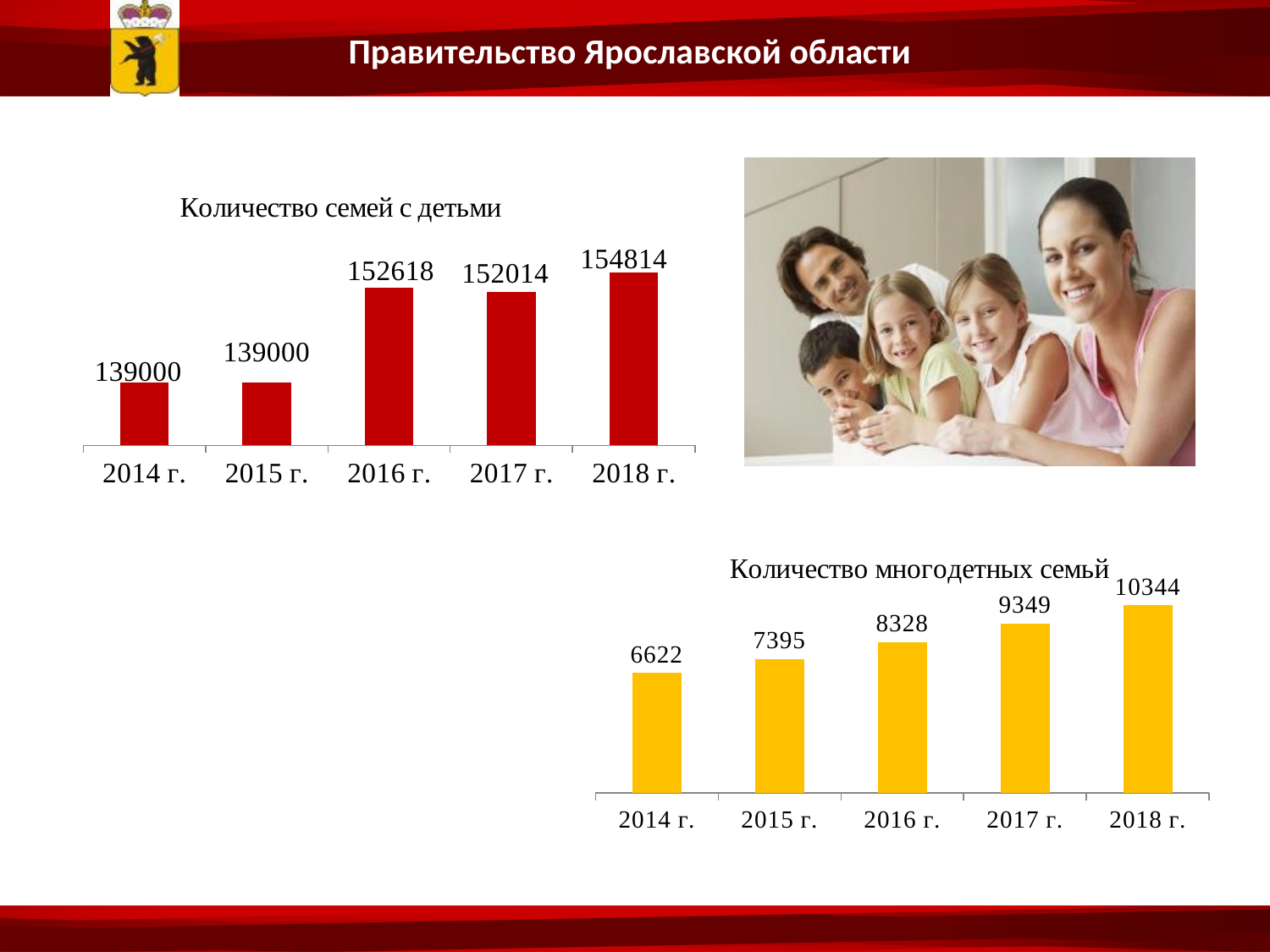
In the chart titled 'Количество семей с детьми', what is the difference between the values for 2018 г. and 2017 г.? 2800 What colour are the bars in the chart titled 'Количество семей с детьми'? Red In the chart titled 'Количество многодетных семей', which year has the lowest value? 2014 г. In the chart titled 'Количество семей с детьми', how many years are shown on the x axis? 5 In the chart titled 'Количество многодетных семей', what is the value for 2017 г.? 9349 In the chart titled 'Количество семей с детьми', which year has the highest value? 2018 г. In the chart titled 'Количество семей с детьми', what is the value for 2016 г.? 152618 In the chart titled 'Количество многодетных семей', what is the value for 2014 г.? 6622 In the chart titled 'Количество многодетных семей', do the values rise or fall from 2014 г. to 2018 г.? Rise In the chart titled 'Количество семей с детьми', is the value for 2016 г. larger than the value for 2017 г.? Yes What kind of chart is the chart titled 'Количество многодетных семей'? Bar chart In the chart titled 'Количество многодетных семей', what is the difference between the values for 2018 г. and 2014 г.? 3722